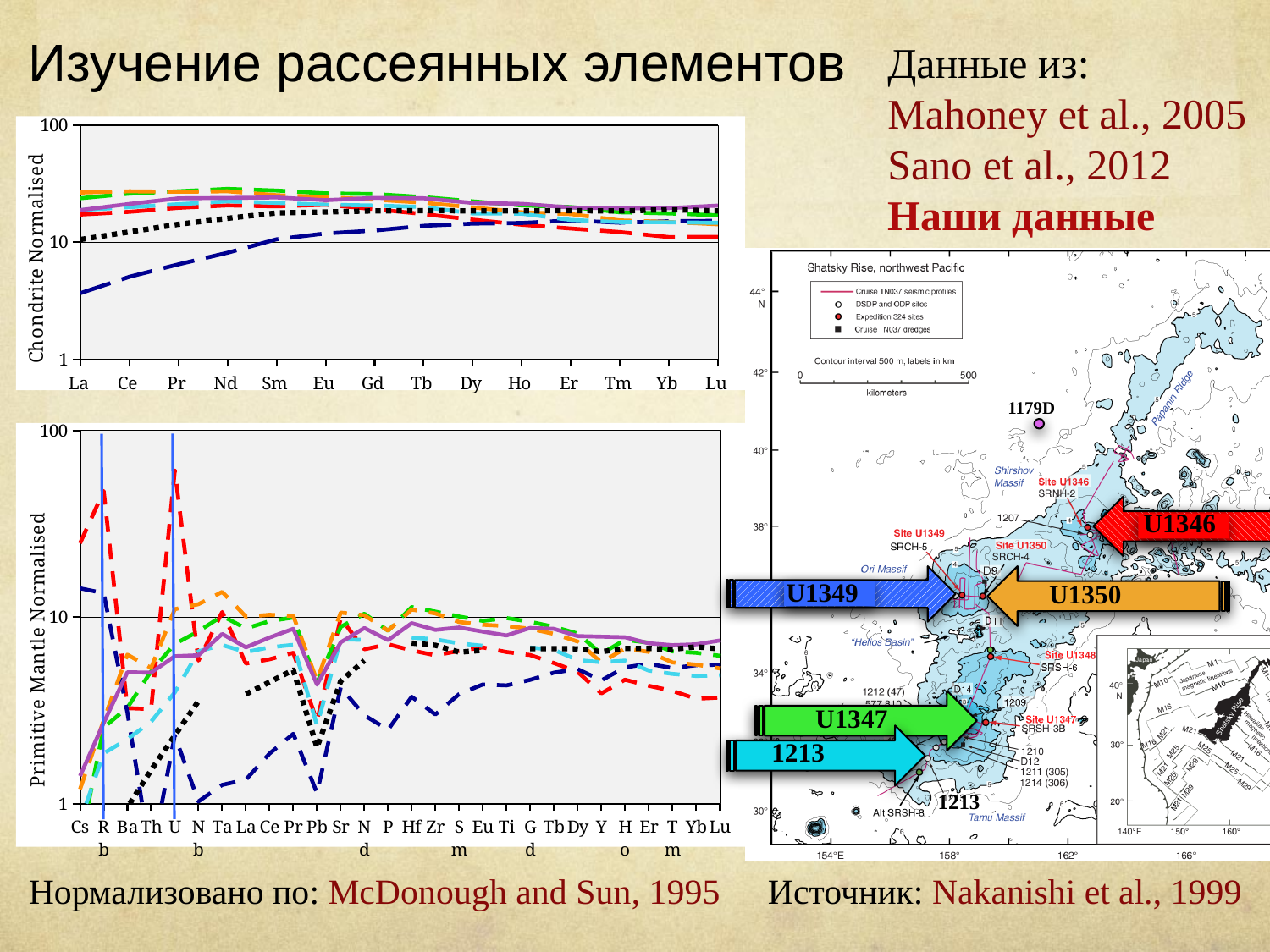
What is the y-axis label of the top chart? Chondrite Normalised What is the y-axis label of the bottom chart? Primitive Mantle Normalised In the bottom chart (Primitive Mantle Normalised), is the value of the red dashed line at U greater or less than 10? greater In the top chart (Chondrite Normalised), is the value of the dark blue dashed line at La greater or less than 10? less What kind of chart is the bottom chart (Primitive Mantle Normalised)? line chart In the bottom chart (Primitive Mantle Normalised), is the value of the dark blue dashed line at Pb greater or less than 10? less What kind of chart is the top chart (Chondrite Normalised)? line chart In the top chart (Chondrite Normalised), at La, which is larger: the purple solid line or the dark blue dashed line? purple solid line In the bottom chart (Primitive Mantle Normalised), at U, which is larger: the red dashed line or the black dotted line? red dashed line How many elements are listed along the x axis of the top chart (Chondrite Normalised)? 14 In the top chart (Chondrite Normalised), does the dark blue dashed line rise or fall from La to Lu? rise